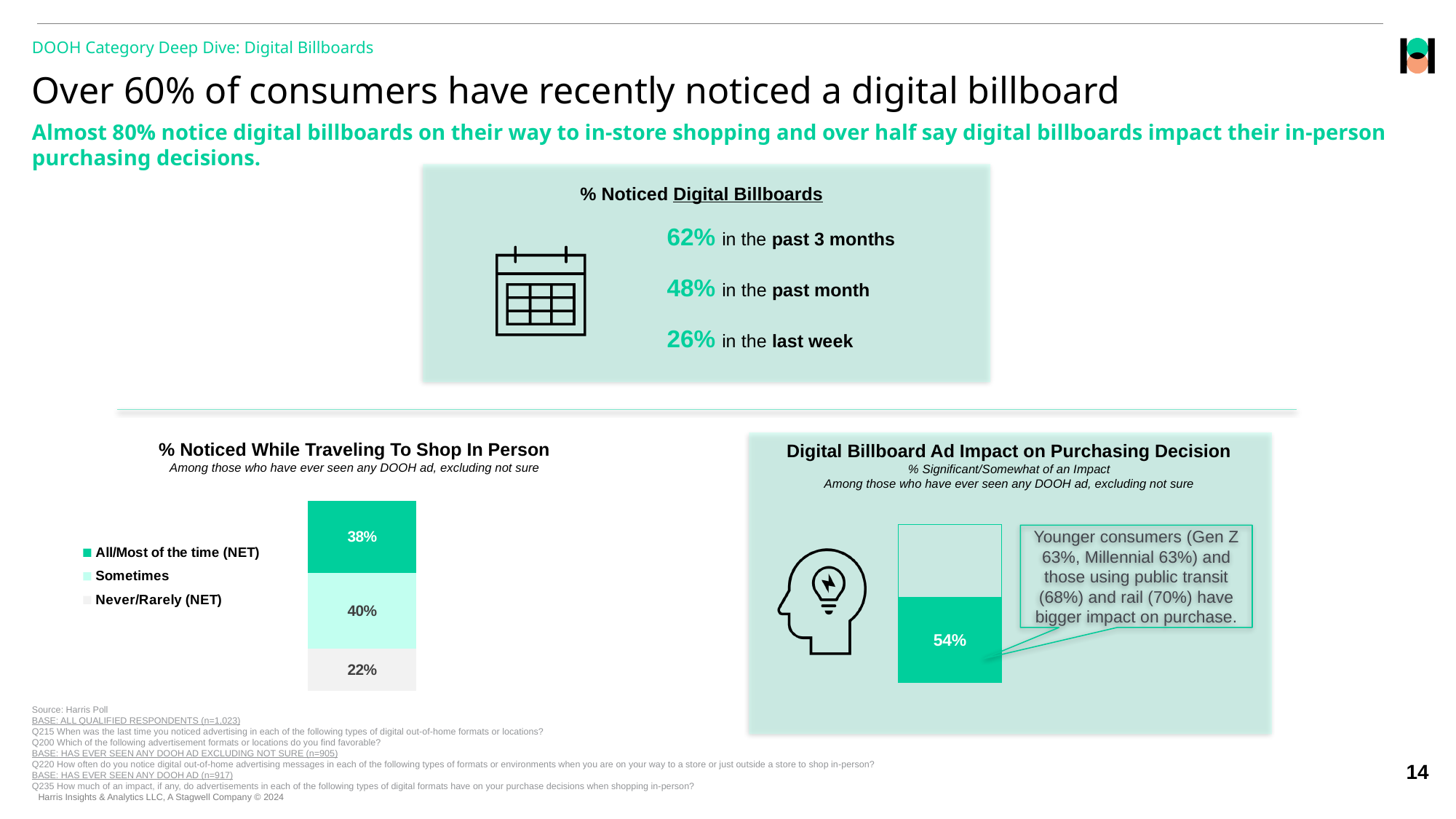
In the '% Noticed While Traveling To Shop In Person' chart, what is the difference between the 'Sometimes' and 'Never/Rarely (NET)' values? 18% In the '% Noticed While Traveling To Shop In Person' chart, what is the value for 'Sometimes'? 40% In the '% Noticed While Traveling To Shop In Person' chart, which legend entry is shown in the darkest green colour? All/Most of the time (NET) In the '% Noticed While Traveling To Shop In Person' chart, what is the value for 'All/Most of the time (NET)'? 38% In the '% Noticed While Traveling To Shop In Person' chart, which segment has the largest value? Sometimes How many entries does the legend of the '% Noticed While Traveling To Shop In Person' chart list? 3 In the '% Noticed While Traveling To Shop In Person' chart, what is the value for 'Never/Rarely (NET)'? 22% In the 'Digital Billboard Ad Impact on Purchasing Decision' chart, what value is shown on the bar? 54% In the '% Noticed While Traveling To Shop In Person' chart, is the value for 'All/Most of the time (NET)' larger or smaller than the value for 'Never/Rarely (NET)'? larger What kind of chart is the '% Noticed While Traveling To Shop In Person' chart? stacked bar chart In the '% Noticed While Traveling To Shop In Person' chart, which segment has the smallest value? Never/Rarely (NET) In the '% Noticed While Traveling To Shop In Person' chart, what is the total of the stacked bar? 100%